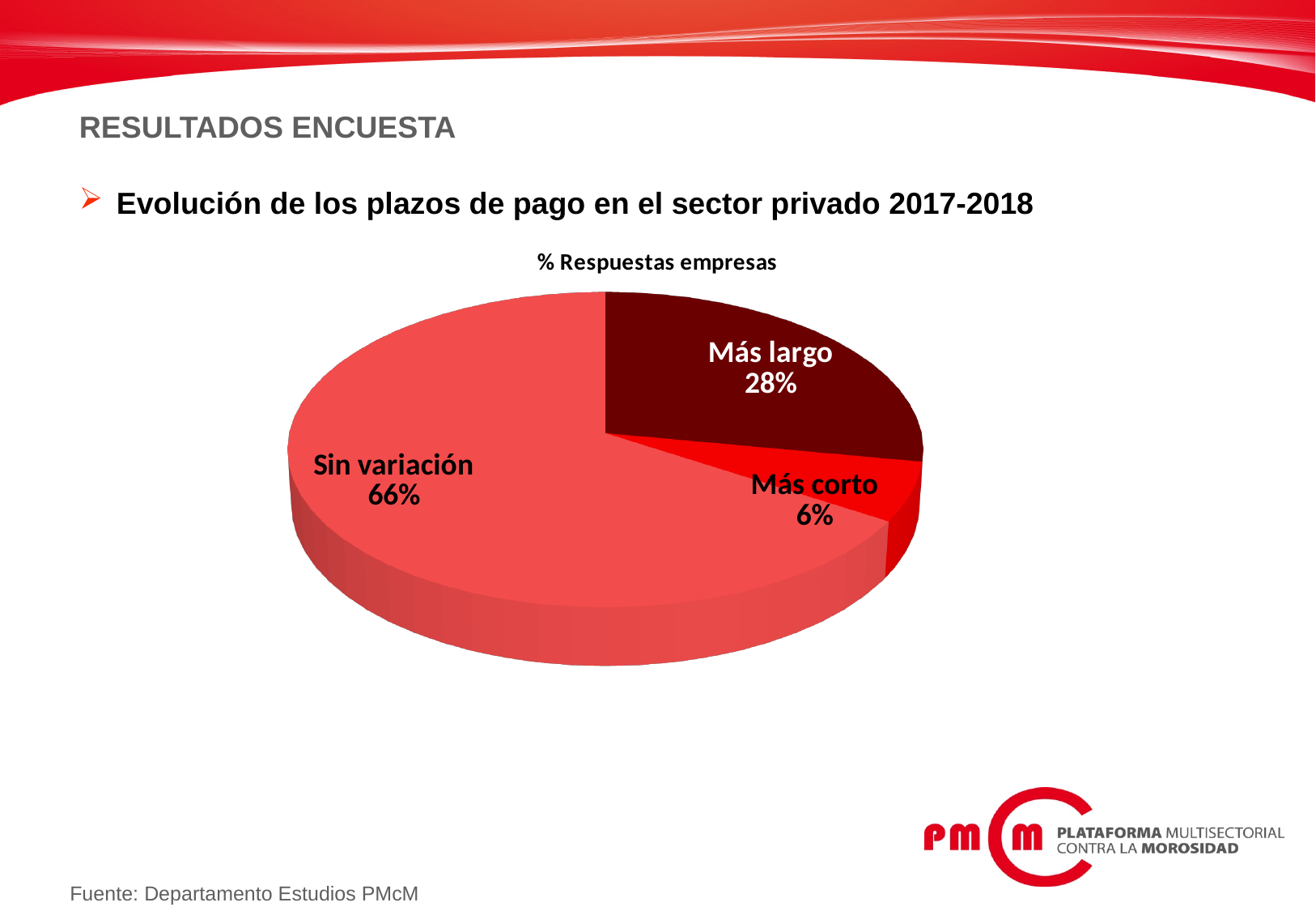
What is the difference in percentage points between 'Sin variación' and 'Más largo'? 38 What type of chart is shown on the slide? Pie chart Which category has the largest share of the pie? Sin variación What percentage of responses is 'Sin variación'? 66% What is the difference in percentage points between 'Más largo' and 'Más corto'? 22 How many slices does the pie chart have? 3 Which category has the smallest share of the pie? Más corto What percentage of responses is 'Más corto'? 6% Which is larger, the share for 'Más largo' or the share for 'Más corto'? Más largo What percentage of responses is 'Más largo'? 28% What is the title of the chart? % Respuestas empresas What colour is the 'Más largo' slice? Dark red